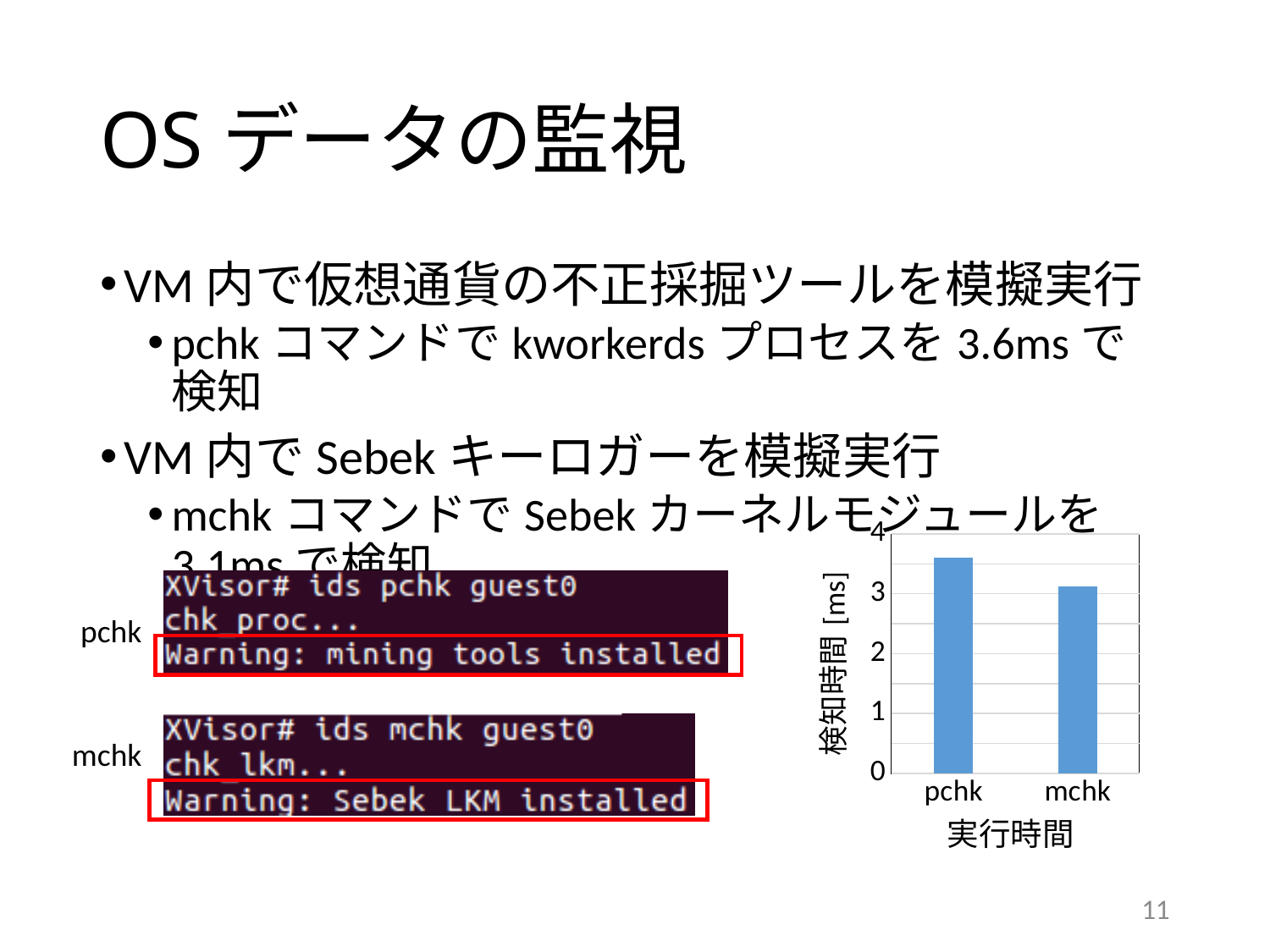
Is the value for pchk greater or less than 3? greater What is the title of the chart? 実行時間 Which category has the highest value in the chart? pchk Which category has the lowest value in the chart? mchk Is the value for mchk greater or less than 2? greater Is the value for pchk greater or less than 4? less What is the label of the vertical axis of the chart? 検知時間 [ms] What kind of chart is shown on the slide? bar chart How many categories are plotted in the chart? 2 Do the values rise or fall from pchk to mchk along the x axis? fall Which has a larger value in the chart, pchk or mchk? pchk